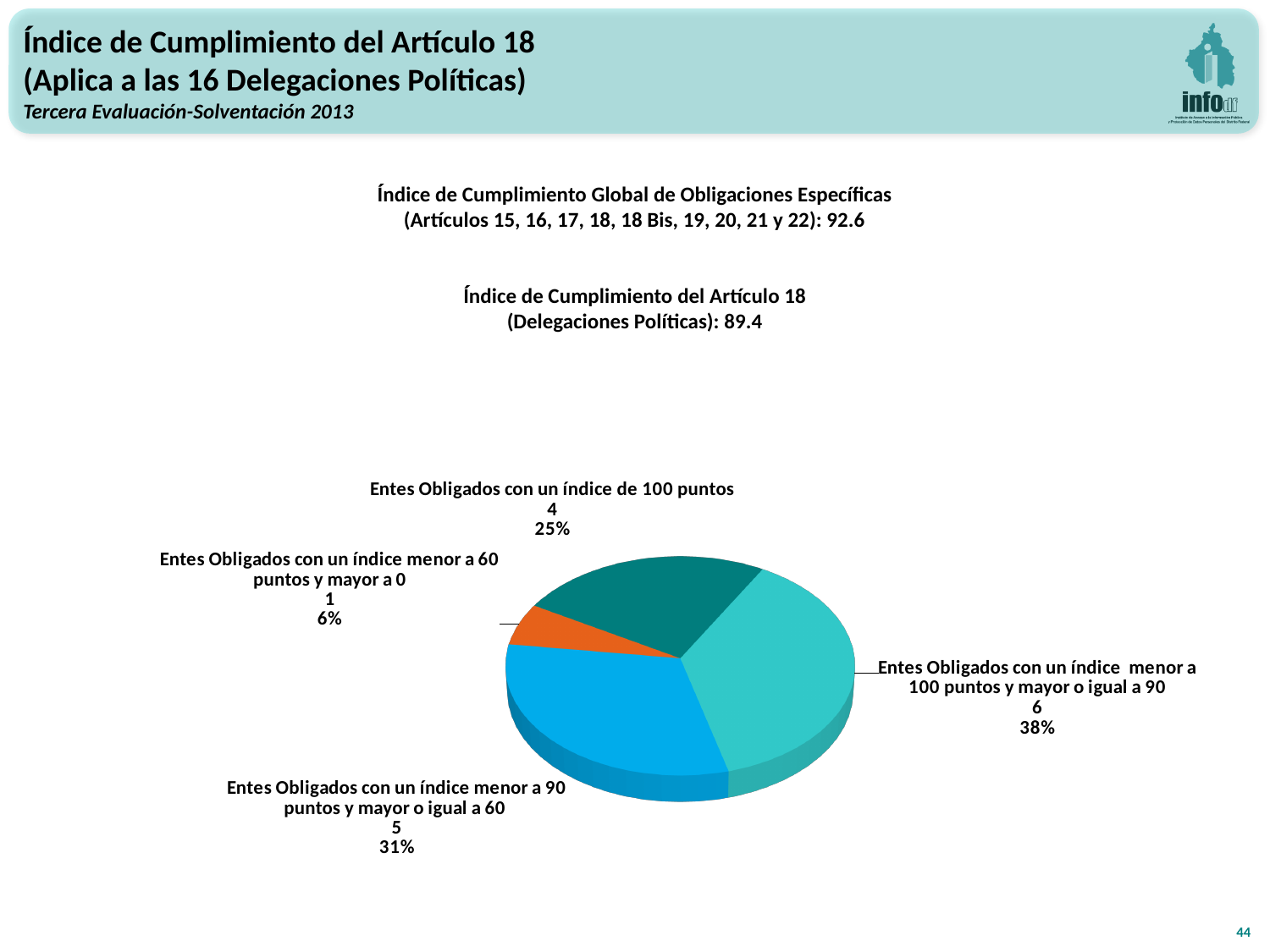
How many slices does the pie chart have? 4 What is the difference in count between Entes Obligados con un índice menor a 100 puntos y mayor o igual a 90 and Entes Obligados con un índice de 100 puntos? 2 Which category has the smallest slice of the pie? Entes Obligados con un índice menor a 60 puntos y mayor a 0 What is the Índice de Cumplimiento del Artículo 18 (Delegaciones Políticas) stated on the slide? 89.4 How many Entes Obligados have an índice menor a 90 puntos y mayor o igual a 60? 5 Which category has the largest slice of the pie? Entes Obligados con un índice menor a 100 puntos y mayor o igual a 90 What is the total number of Entes Obligados across all slices of the pie? 16 Which has more Entes Obligados: índice de 100 puntos or índice menor a 90 puntos y mayor o igual a 60? Índice menor a 90 puntos y mayor o igual a 60 What kind of chart is shown on the slide? Pie chart What percentage of the pie corresponds to Entes Obligados con un índice menor a 60 puntos y mayor a 0? 6% How many Entes Obligados have an índice de 100 puntos? 4 What percentage of the pie corresponds to Entes Obligados con un índice menor a 100 puntos y mayor o igual a 90? 38%